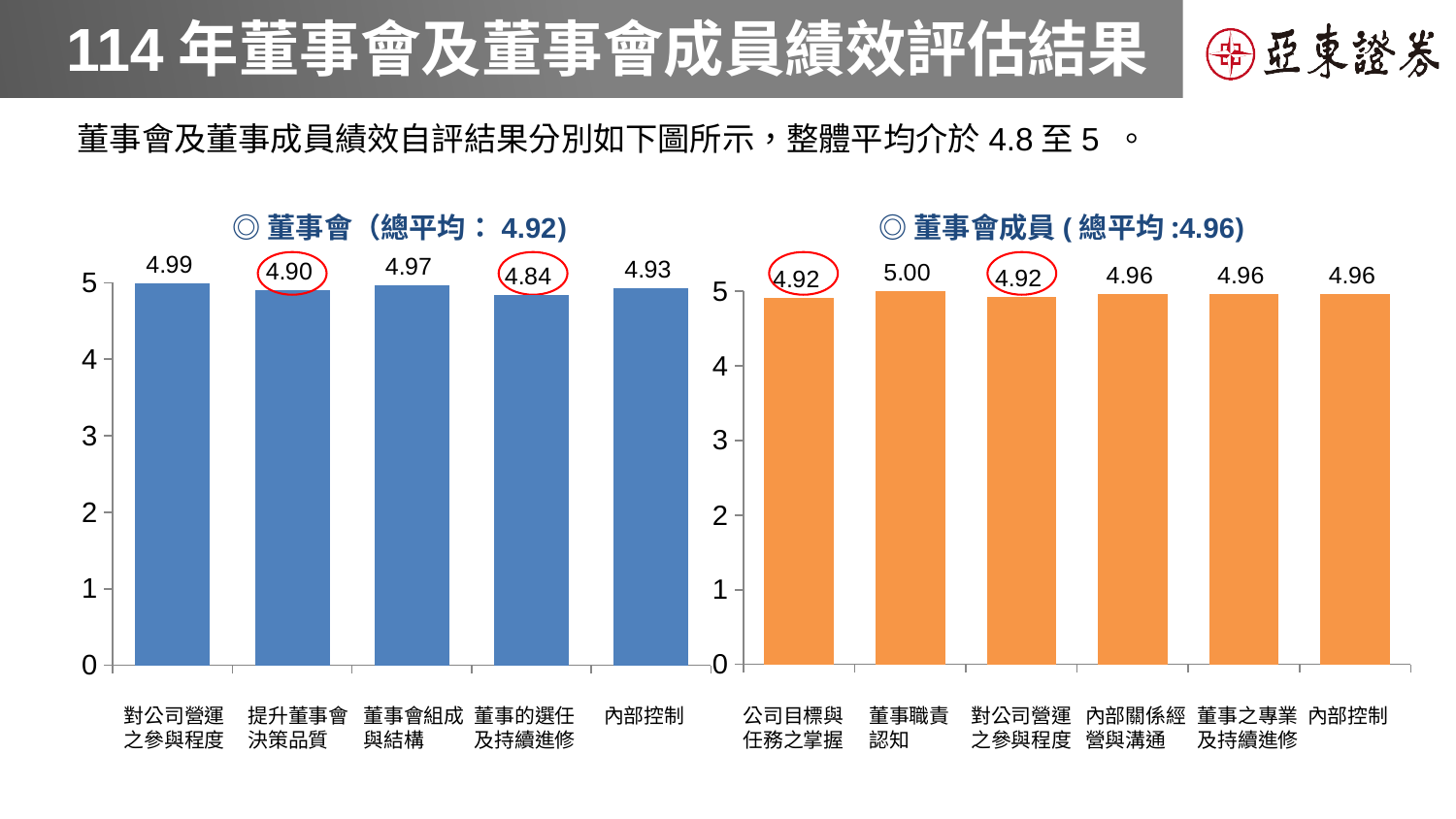
In the 董事會成員 chart on the right, what is the value for 董事職責認知? 5.00 In the 董事會成員 chart on the right, which category has the highest value? 董事職責認知 In the 董事會 chart on the left, what is the value for 董事的選任及持續進修? 4.84 In the 董事會 chart on the left, which category has the lowest value? 董事的選任及持續進修 In the 董事會 chart on the left, how many categories are shown? 5 In the 董事會成員 chart on the right, what is the difference between 董事職責認知 and 對公司營運之參與程度? 0.08 In the 董事會成員 chart on the right, how many categories are shown? 6 In the 董事會 chart on the left, which category has the highest value? 對公司營運之參與程度 In the 董事會 chart on the left, what is the value for 對公司營運之參與程度? 4.99 What type of chart is the 董事會 chart on the left? Bar chart In the 董事會 chart on the left, what is the difference between 對公司營運之參與程度 and 董事的選任及持續進修? 0.15 In the 董事會成員 chart on the right, what is the value for 公司目標與任務之掌握? 4.92